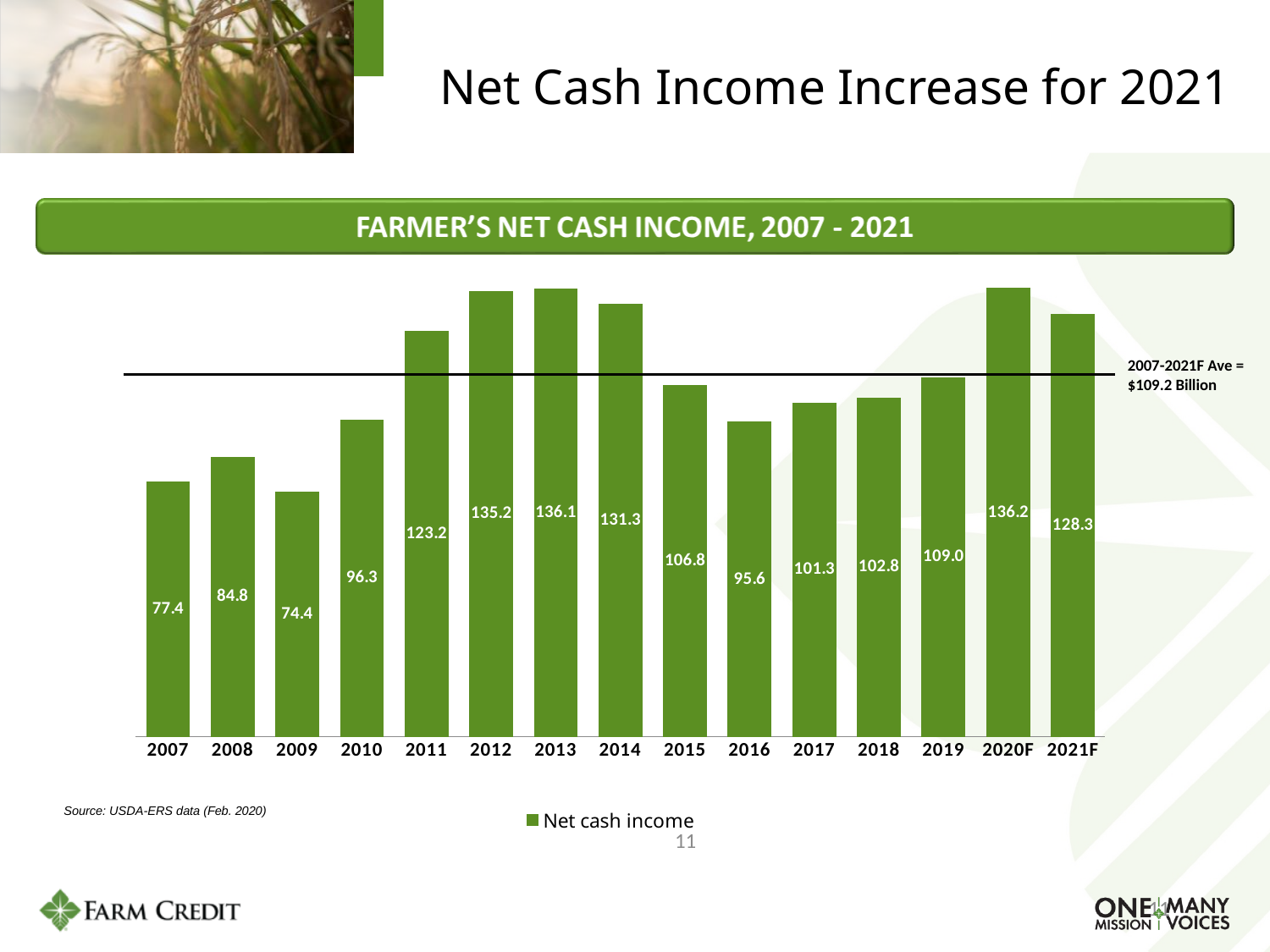
What is the 2007-2021F average value shown by the horizontal line on the chart? $109.2 Billion Which year has the lowest net cash income? 2009 What is the net cash income value for 2011? 123.2 How many years are shown on the x axis of the chart? 15 What is the difference between the net cash income for 2020F and 2021F? 7.9 Which is larger, the net cash income for 2012 or for 2014? 2012 What kind of chart is shown on the slide? Bar chart What is the net cash income value for 2016? 95.6 Which is larger, the net cash income for 2015 or for 2016? 2015 What is the difference between the net cash income for 2011 and 2010? 26.9 How many series does the legend list? 1 What is the net cash income value for 2020F? 136.2